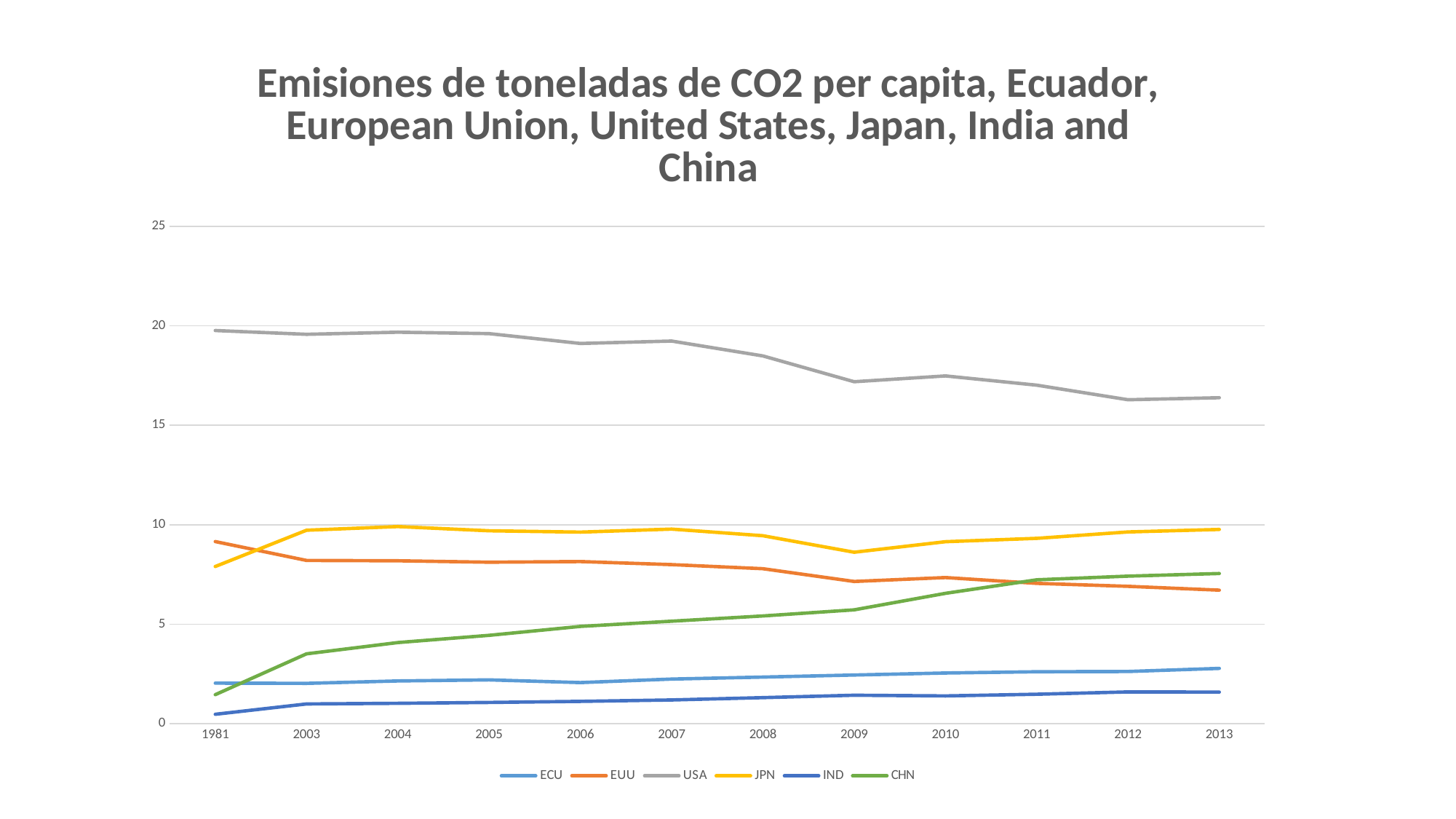
Does the CHN series rise or fall from 1981 to 2013? rise Does the USA series rise or fall from 1981 to 2013? fall Is the value for USA in 1981 greater or less than 15? greater How many series does the legend list? 6 Is the value for CHN in 1981 greater or less than 5? less What kind of chart is shown on the slide? line chart Which is larger in 1981, the value for EUU or the value for JPN? EUU Is the value for JPN in 2013 greater or less than 10? less Which series has the highest CO2 emissions per capita across all years shown? USA Which series has the lowest CO2 emissions per capita across all years shown? IND How many years are shown on the x axis? 12 Which is larger in 2013, the value for CHN or the value for EUU? CHN